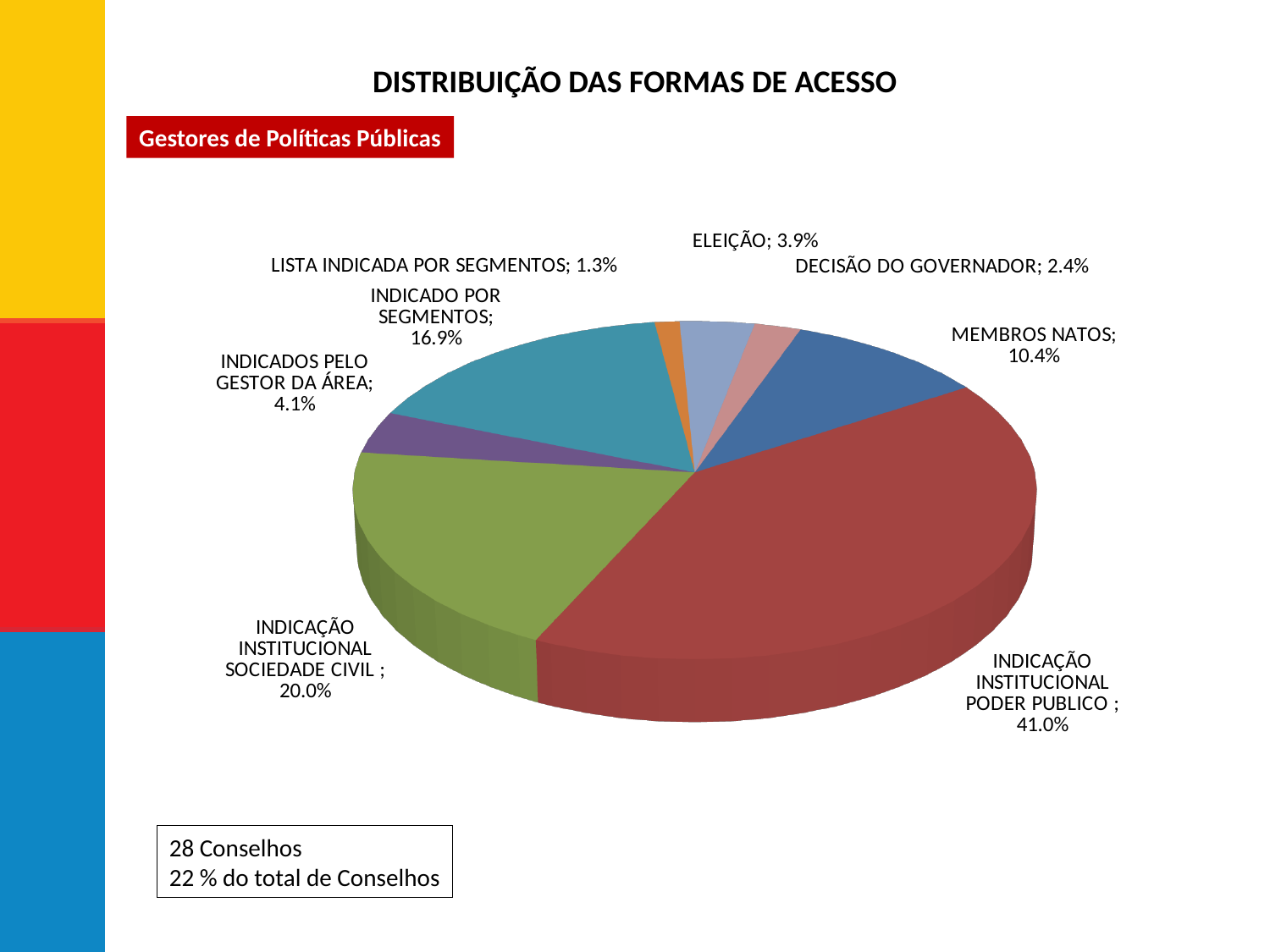
What percentage is shown for DECISÃO DO GOVERNADOR? 2.4% What percentage is shown for INDICADO POR SEGMENTOS? 16.9% What is the title of the chart on the slide? DISTRIBUIÇÃO DAS FORMAS DE ACESSO Which category has the smallest share of the pie? LISTA INDICADA POR SEGMENTOS What kind of chart is shown on the slide? Pie chart What percentage is shown for MEMBROS NATOS? 10.4% What percentage is shown for INDICAÇÃO INSTITUCIONAL PODER PUBLICO? 41.0% What is the share of the pie for INDICADOS PELO GESTOR DA ÁREA? 4.1% How many slices does the pie chart have? 8 Which category has the largest share of the pie? INDICAÇÃO INSTITUCIONAL PODER PUBLICO What is the difference in percentage points between INDICAÇÃO INSTITUCIONAL PODER PUBLICO and INDICAÇÃO INSTITUCIONAL SOCIEDADE CIVIL? 21.0 Which is larger, the share for ELEIÇÃO or the share for DECISÃO DO GOVERNADOR? ELEIÇÃO